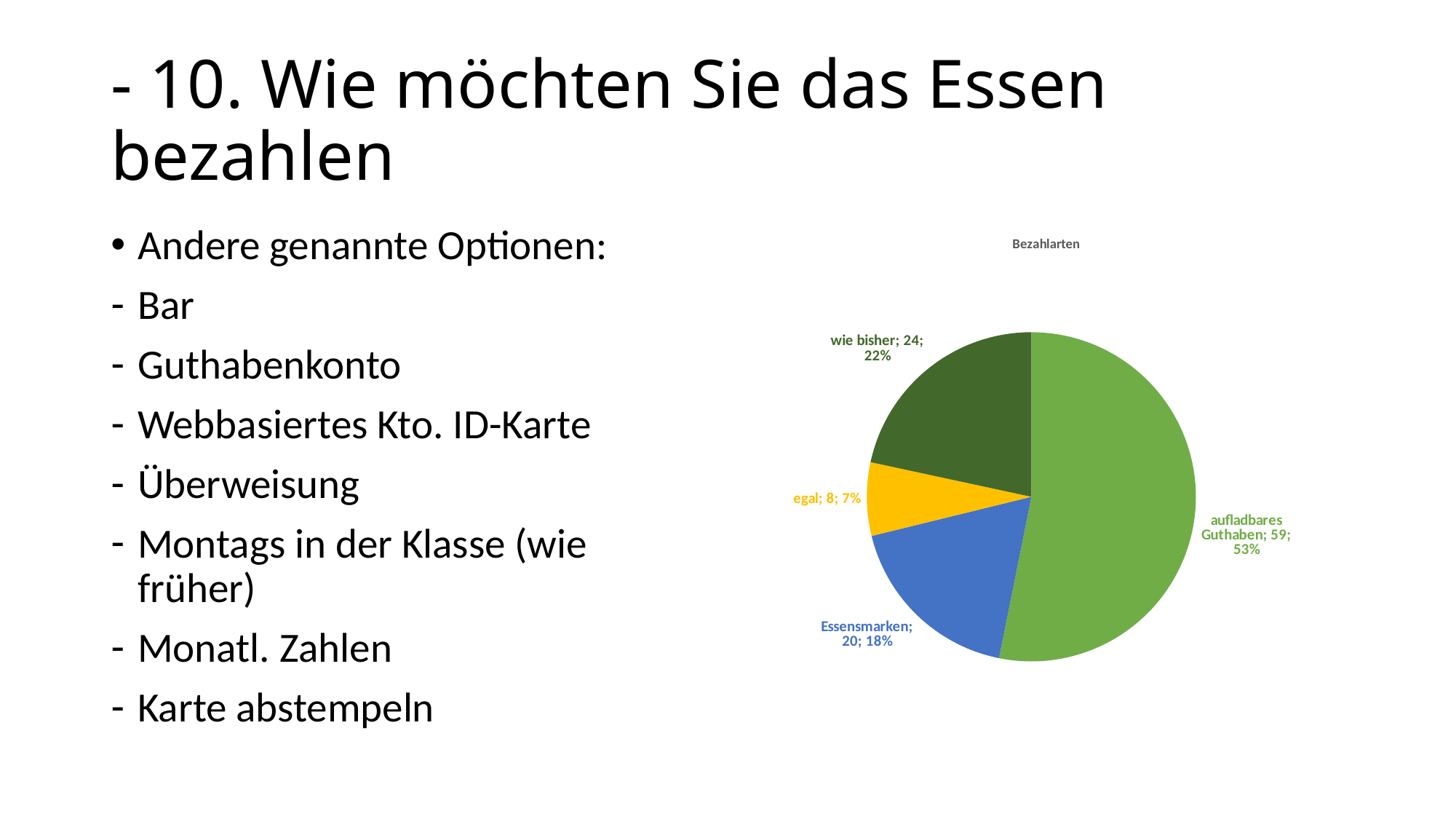
What is the difference between the values for 'wie bisher' and 'Essensmarken'? 4 What share of the pie does 'Essensmarken' represent? 18% What is the value for 'egal'? 8 How many slices does the pie chart have? 4 What is the title of the chart? Bezahlarten Which category has the smallest slice? egal What share of the pie does 'aufladbares Guthaben' represent? 53% Which category has the largest slice? aufladbares Guthaben What is the value for 'wie bisher'? 24 What kind of chart is shown on the slide? pie chart What is the value for 'aufladbares Guthaben'? 59 What is the value for 'Essensmarken'? 20